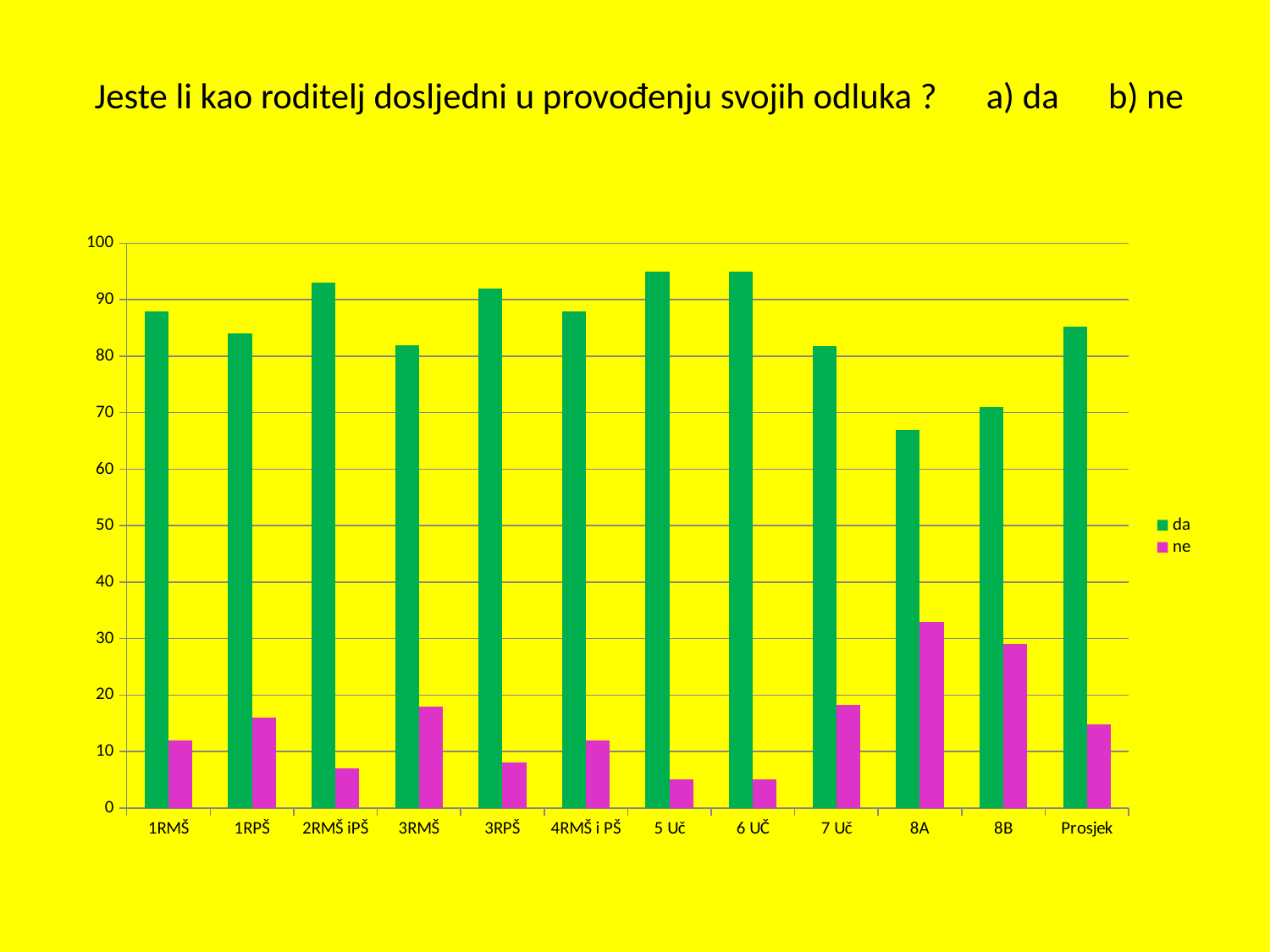
Is the 'da' value for 8A greater or less than 70? less Which has the larger 'da' value, 2RMŠ iPŠ or 3RMŠ? 2RMŠ iPŠ Which category has the highest value for the 'ne' series? 8A Which has the larger 'ne' value, 8B or 1RMŠ? 8B How many categories are shown on the x axis? 12 How many series does the legend list? 2 What kind of chart is shown on the slide? bar chart What colour are the bars for the 'ne' series? magenta Is the 'da' value for 1RMŠ greater or less than 80? greater Is the 'ne' value for 2RMŠ iPŠ greater or less than 10? less Which category has the lowest value for the 'da' series? 8A